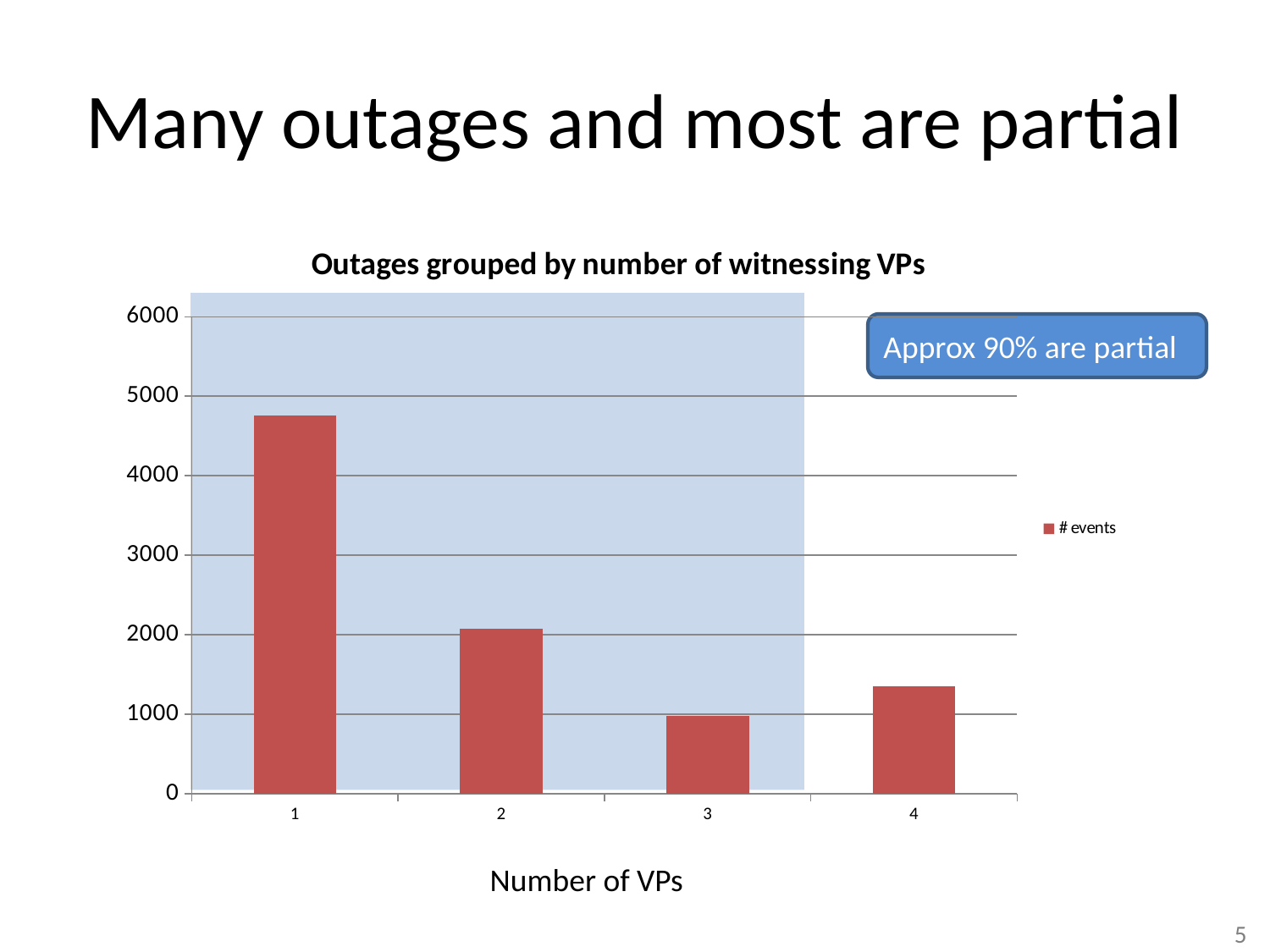
Is the value for 2 VPs greater or less than 3000? less Which number of VPs has the lowest number of events? 3 How many categories are shown on the x axis of the chart? 4 How many series does the chart legend list? 1 Do the values rise or fall from 1 VP to 3 VPs? fall What is the title of the chart? Outages grouped by number of witnessing VPs Is the value for 1 VP greater or less than 4000? greater Which has more events, 2 VPs or 4 VPs? 2 VPs Which number of VPs has the highest number of events? 1 What is the name of the series shown in the legend? # events What type of chart is shown on the slide? bar chart